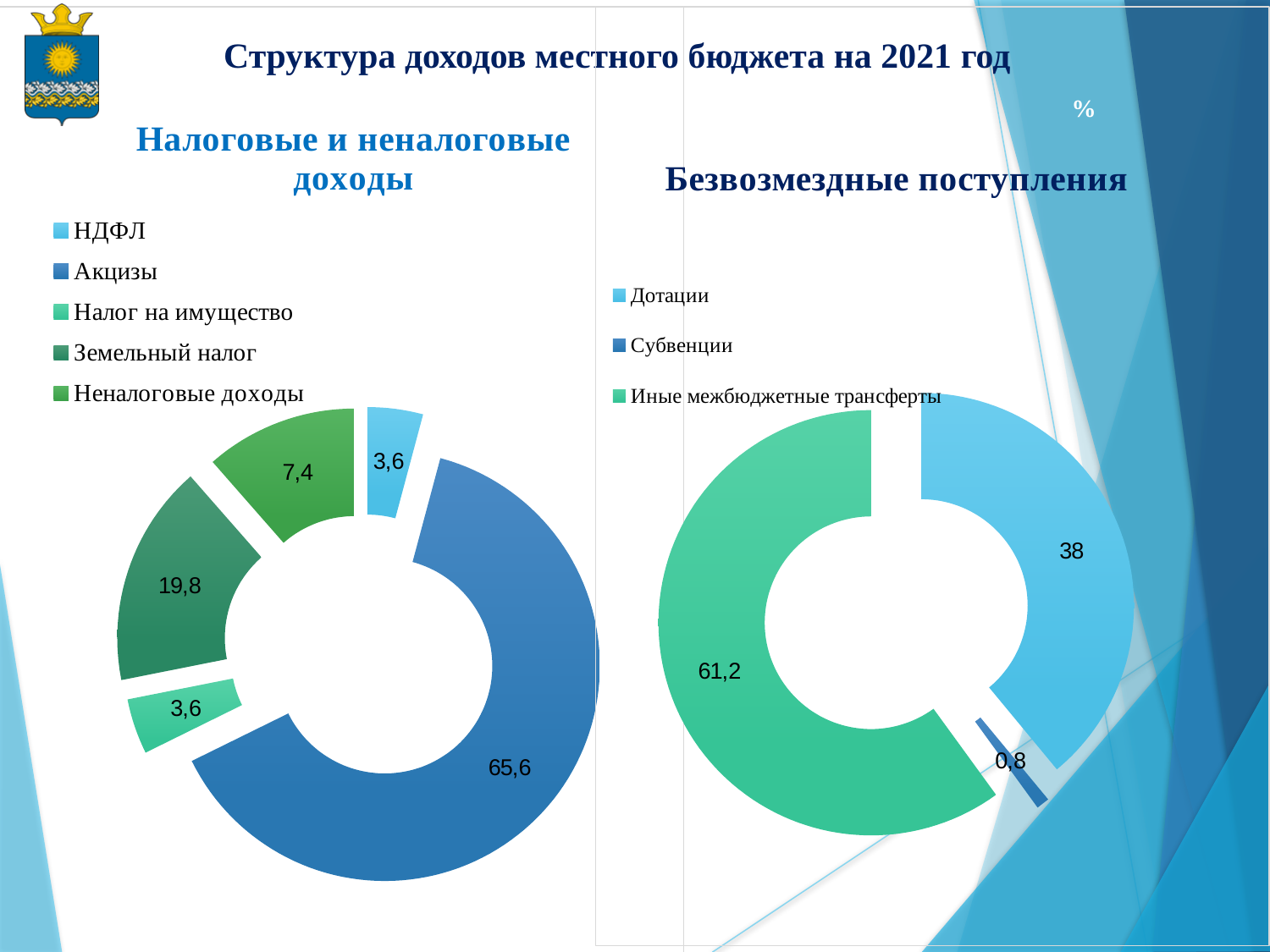
In the chart 'Налоговые и неналоговые доходы', how many categories are shown? 5 In the chart 'Налоговые и неналоговые доходы', what is the value for Акцизы? 65,6 What type of chart is used for 'Безвозмездные поступления'? Doughnut chart In the chart 'Налоговые и неналоговые доходы', what is the value for Неналоговые доходы? 7,4 In the chart 'Безвозмездные поступления', how many entries does the legend list? 3 In the chart 'Налоговые и неналоговые доходы', what is the value for Земельный налог? 19,8 In the chart 'Безвозмездные поступления', what is the value for Дотации? 38 In the chart 'Безвозмездные поступления', which category has the smallest share? Субвенции In the chart 'Безвозмездные поступления', which is larger: Дотации or Иные межбюджетные трансферты? Иные межбюджетные трансферты In the chart 'Налоговые и неналоговые доходы', which category has the largest share? Акцизы In the chart 'Безвозмездные поступления', what is the value for Субвенции? 0,8 In the chart 'Налоговые и неналоговые доходы', what is the difference between Земельный налог and Неналоговые доходы? 12,4